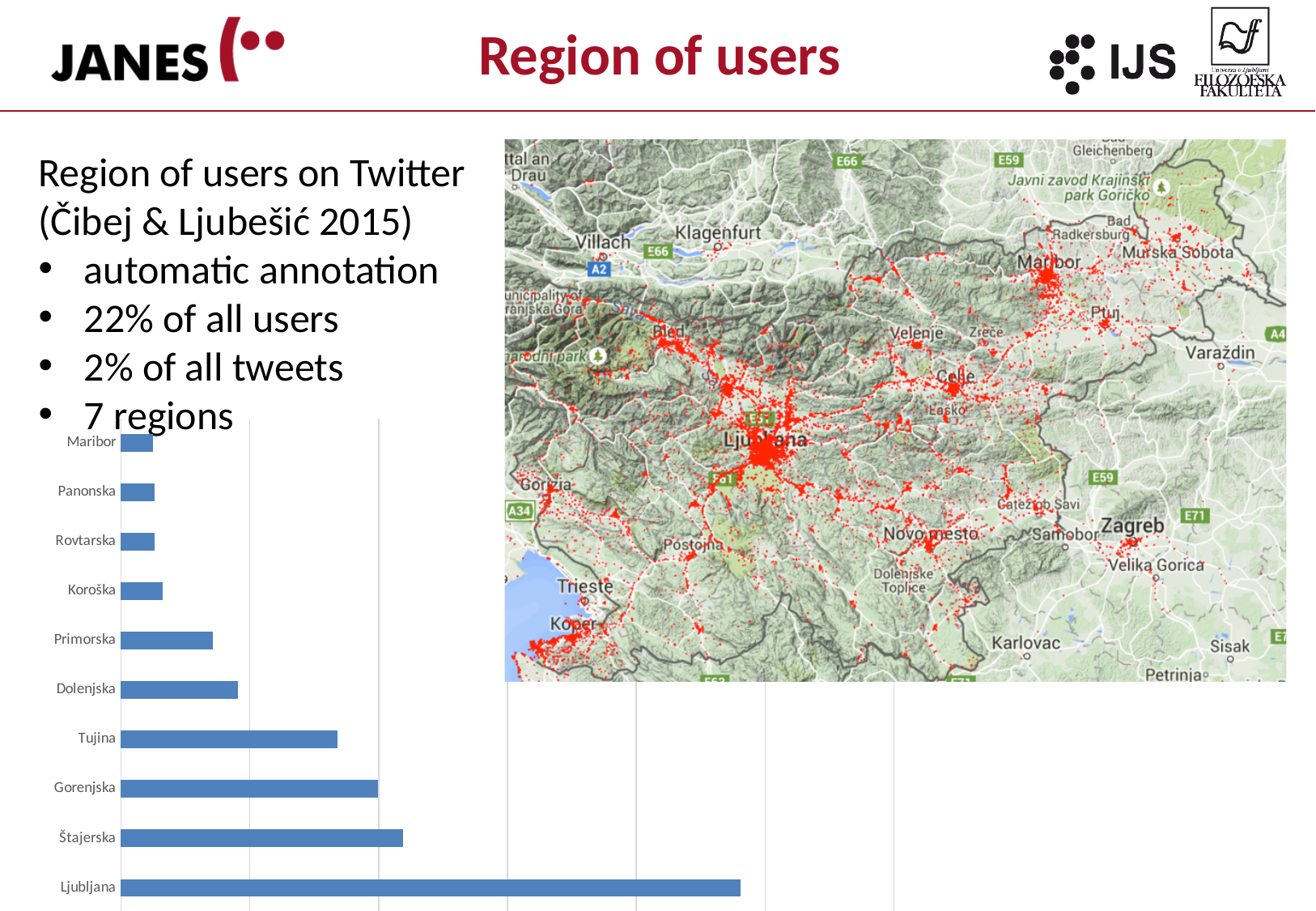
What colour are the bars in the chart? blue What kind of chart is shown on the slide? bar chart Which category has the highest value in the bar chart? Ljubljana Which category is listed at the top of the bar chart? Maribor Which has the larger value, Primorska or Koroška? Primorska How many categories does the bar chart show? 10 Which has the larger value, Ljubljana or Štajerska? Ljubljana Which has the larger value, Tujina or Dolenjska? Tujina